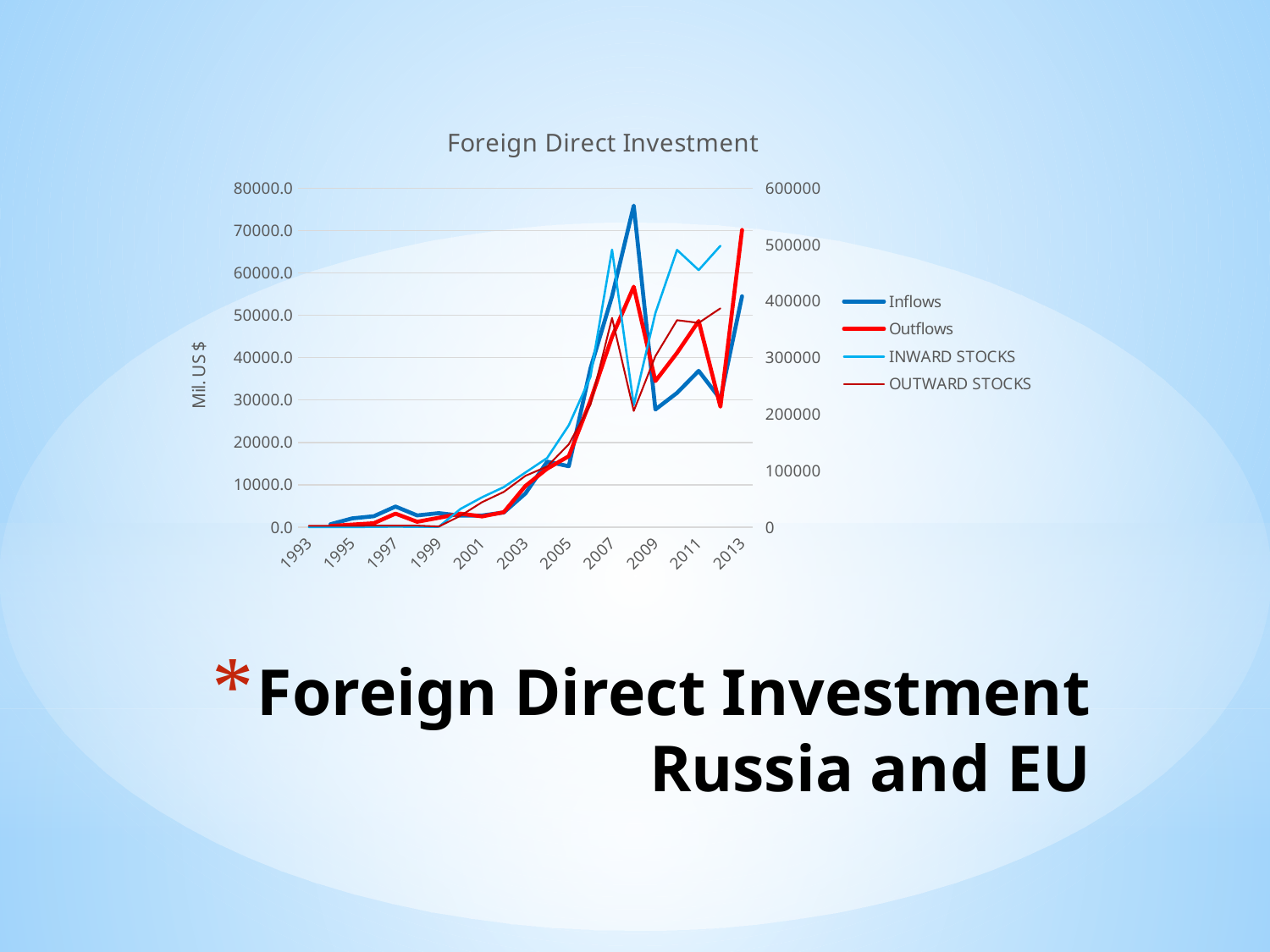
What is the highest value shown on the right vertical axis? 600000 How many series does the legend list? 4 What is the title of the chart? Foreign Direct Investment What is the label on the left vertical axis? Mil. US $ Is the peak value of the Inflows series greater or less than 70000.0 on the left axis? greater What is the highest value shown on the left vertical axis? 80000.0 In 2013, which series is higher, Inflows or Outflows? Outflows What is the first year shown on the x axis? 1993 What is the last year shown on the x axis? 2013 Does the Inflows series generally rise or fall from 1993 to 2007? rise What kind of chart is shown on the slide? line chart Is the value of Outflows in 2013 greater or less than 60000.0 on the left axis? greater